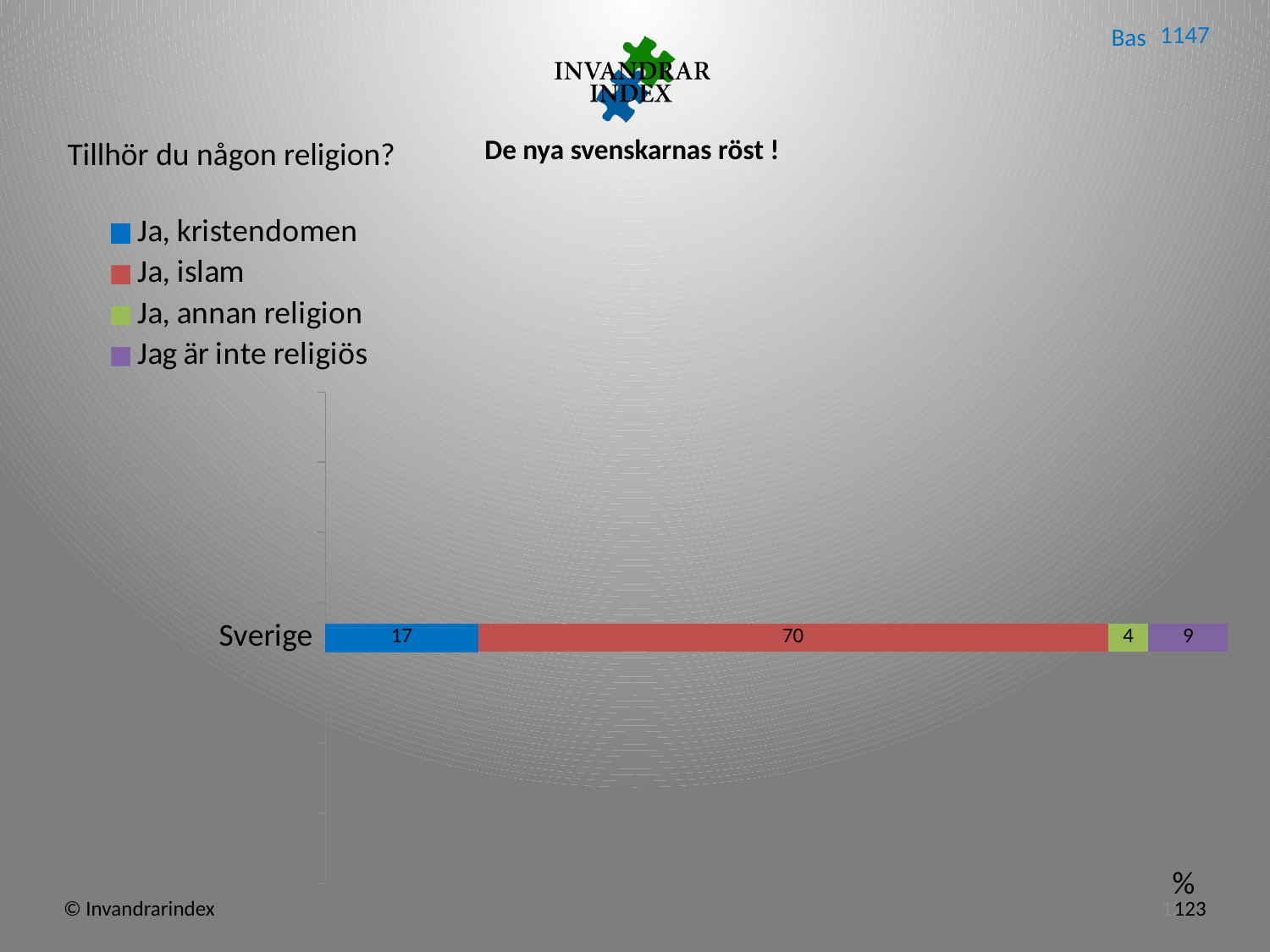
What is the total of the stacked bar for Sverige? 100 What is the difference between the values for "Ja, islam" and "Ja, kristendomen" for Sverige? 53 What is the value for "Jag är inte religiös" for Sverige? 9 What is the value for "Ja, annan religion" for Sverige? 4 Which series has the lowest value for Sverige? Ja, annan religion What is the value for "Ja, kristendomen" for Sverige? 17 How many series does the legend list? 4 Which is larger for Sverige: "Jag är inte religiös" or "Ja, annan religion"? Jag är inte religiös How many categories are plotted on the chart? 1 What kind of chart is shown on the slide? Stacked bar chart What is the value for "Ja, islam" for Sverige? 70 Which series has the highest value for Sverige? Ja, islam